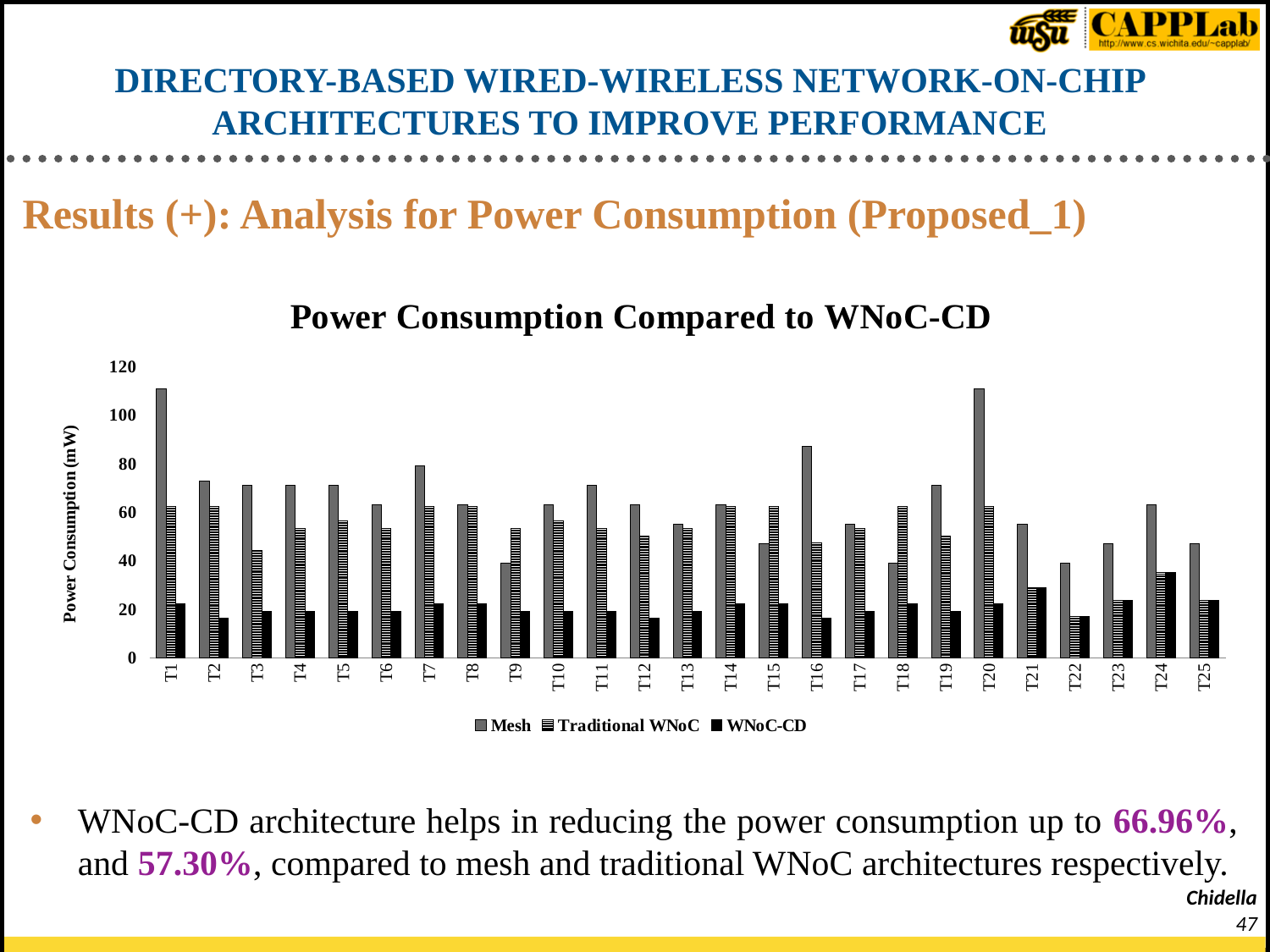
Is the WNoC-CD value for T24 greater or less than 20? greater What is the title of the chart? Power Consumption Compared to WNoC-CD Is the Mesh value for T9 greater or less than 60? less How many series does the legend list? 3 Is the Mesh value for T16 greater or less than 80? greater What kind of chart is shown on the slide? bar chart Which category has the highest WNoC-CD value? T24 What is the label of the vertical axis? Power Consumption (mW) How many categories (T1 to T25) are shown on the x axis? 25 Which is larger, the Mesh value for T16 or the Mesh value for T7? T16